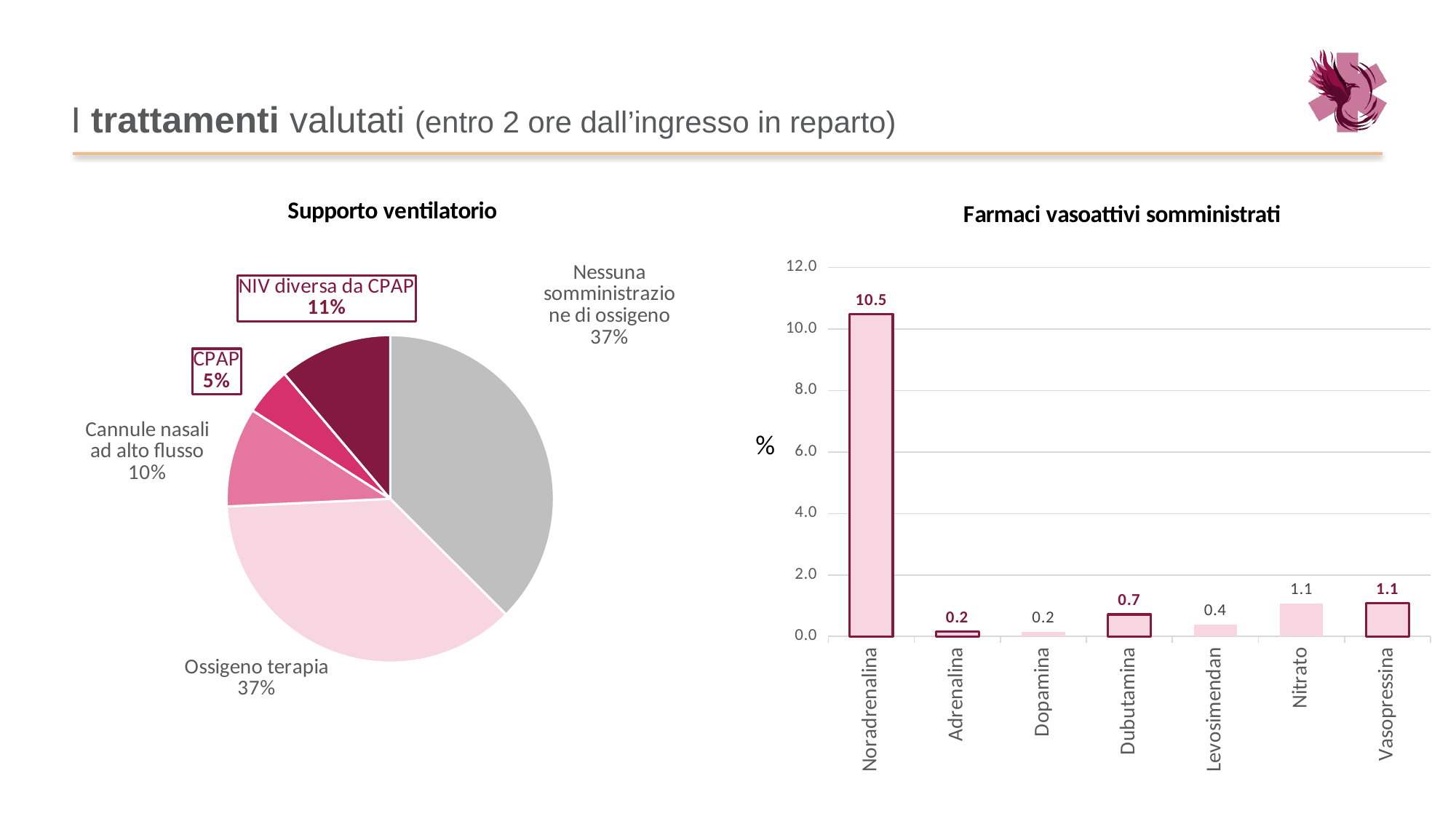
What kind of chart is 'Farmaci vasoattivi somministrati'? Bar chart In the 'Farmaci vasoattivi somministrati' chart, what is the value for 'Noradrenalina'? 10.5 In the 'Supporto ventilatorio' chart, how many slices does the pie have? 5 In the 'Supporto ventilatorio' chart, which category has the smallest slice? CPAP In the 'Supporto ventilatorio' chart, what share of the pie is 'Ossigeno terapia'? 37% In the 'Farmaci vasoattivi somministrati' chart, which drug has the highest value? Noradrenalina What kind of chart is 'Supporto ventilatorio'? Pie chart In the 'Farmaci vasoattivi somministrati' chart, what is the value for 'Levosimendan'? 0.4 In the 'Farmaci vasoattivi somministrati' chart, which is larger, 'Dubutamina' or 'Levosimendan'? Dubutamina In the 'Farmaci vasoattivi somministrati' chart, what is the difference between 'Noradrenalina' and 'Nitrato'? 9.4 In the 'Supporto ventilatorio' chart, what is the value for 'NIV diversa da CPAP'? 11% In the 'Supporto ventilatorio' chart, what is the value for 'CPAP'? 5%